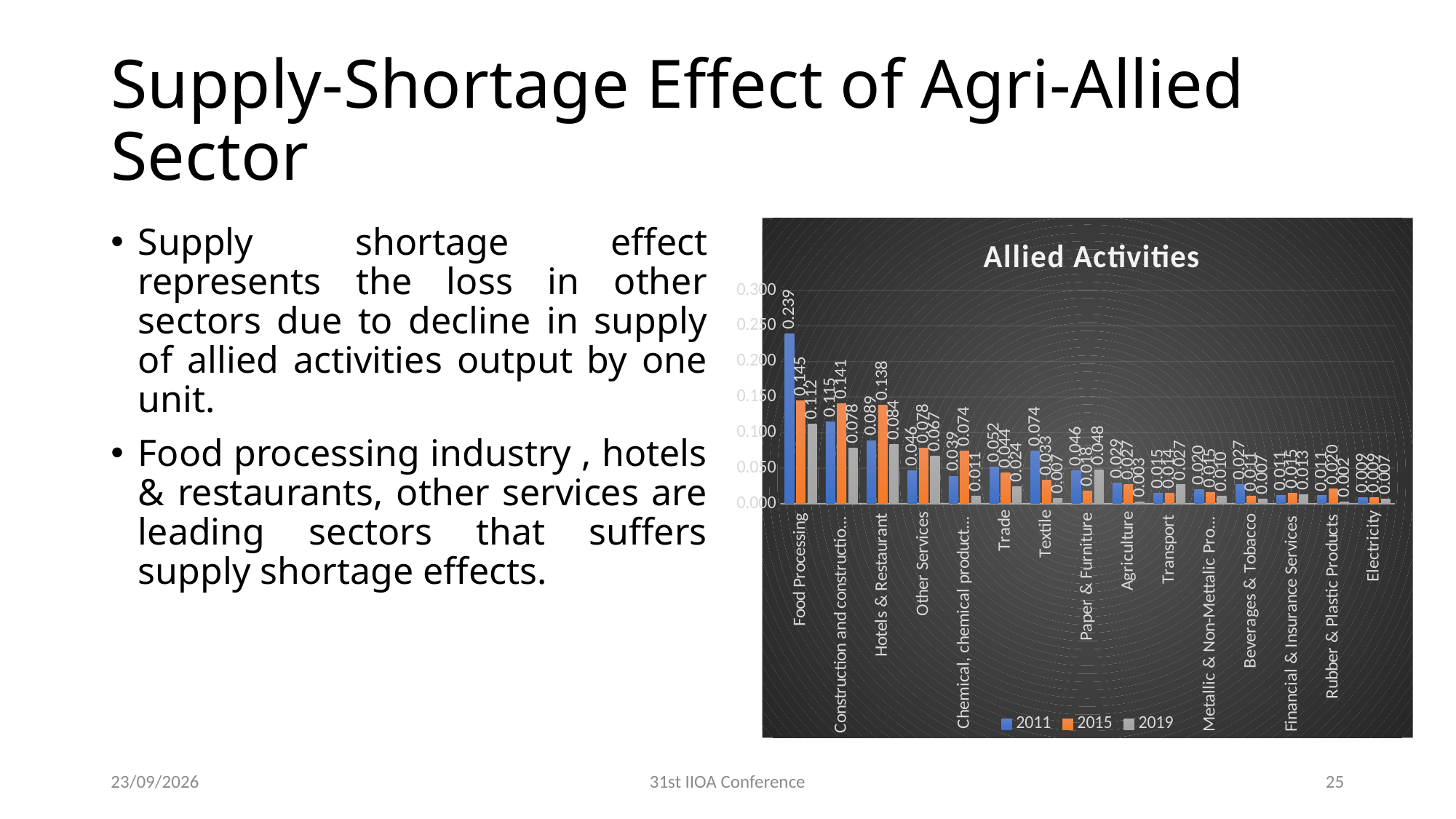
What is the 2015 value for Hotels & Restaurant? 0.138 Is the 2011 value for Food Processing greater or less than 0.200? greater Do the 2011 values generally rise or fall from left to right along the x axis? fall Which category has the highest 2011 value? Food Processing What is the title of the chart? Allied Activities What is the difference between the 2011 and 2015 values for Food Processing? 0.094 How many series does the legend of the chart list? 3 What is the 2011 value for Food Processing? 0.239 How many categories are shown on the x axis of the chart? 15 For Construction and construction, which is larger: the 2011 value or the 2015 value? 2015 What is the 2011 value for Textile? 0.074 What kind of chart is shown on the slide? bar chart